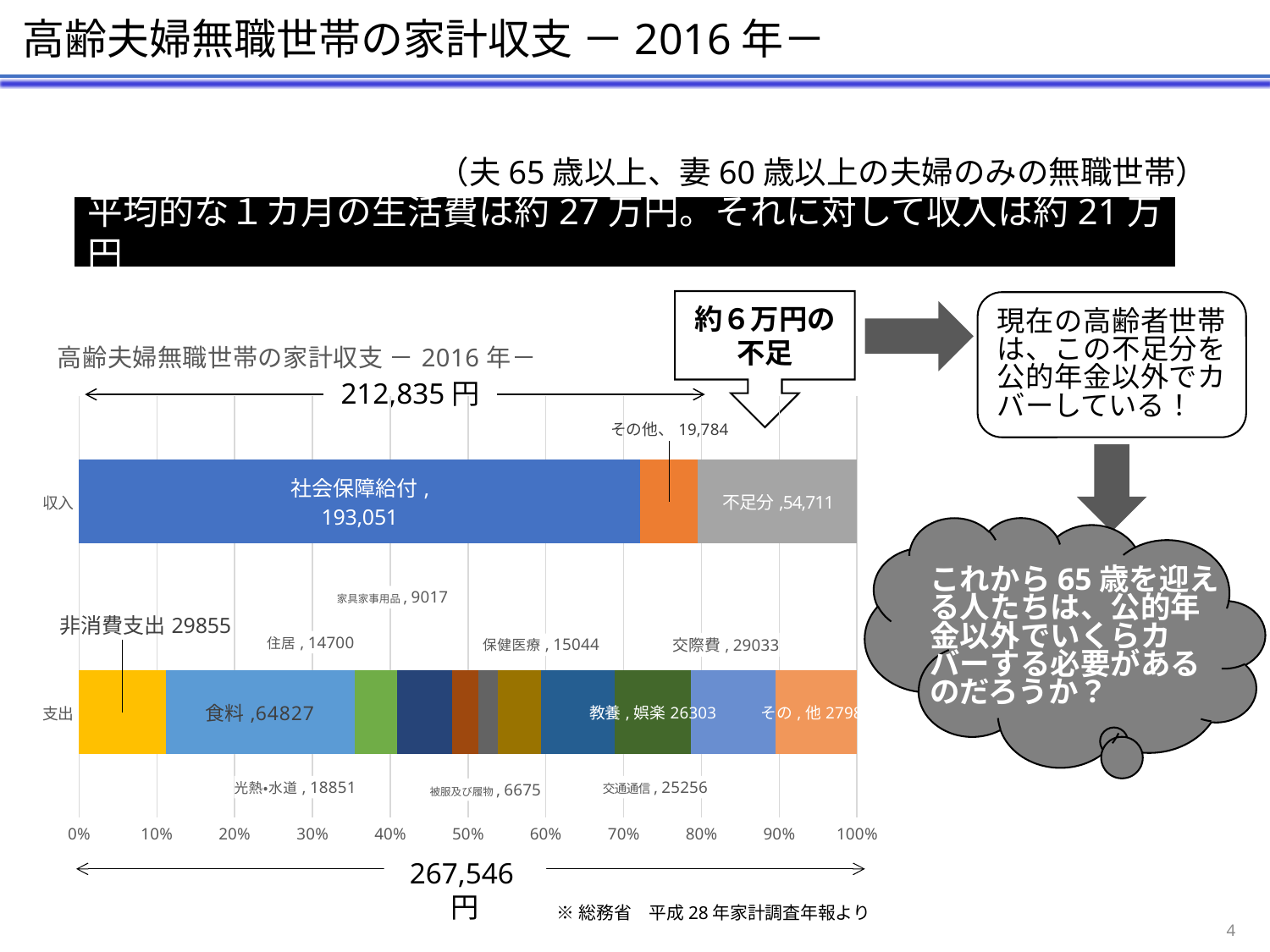
Which is larger in the 支出 bar, 交際費 or 保健医療? 交際費 What is the difference between 食料 (64827) and 非消費支出 (29855) in the 支出 bar? 34972 What is the difference between 社会保障給付 (193,051) and その他 (19,784) in the 収入 bar? 173,267 What is the value of 社会保障給付 in the 収入 bar? 193,051 How many categories (bars) are plotted on the chart? 2 What is the value of 交通通信 in the 支出 bar? 25256 What is the value of 不足分 in the 収入 bar? 54,711 What is the title of the chart? 高齢夫婦無職世帯の家計収支 － 2016 年－ What is the value of 食料 in the 支出 bar? 64827 What type of chart is shown on the slide? Stacked bar chart What is the total of the 収入 bar (社会保障給付 + その他 + 不足分)? 267,546 Which segment is the largest in the 支出 bar? 食料